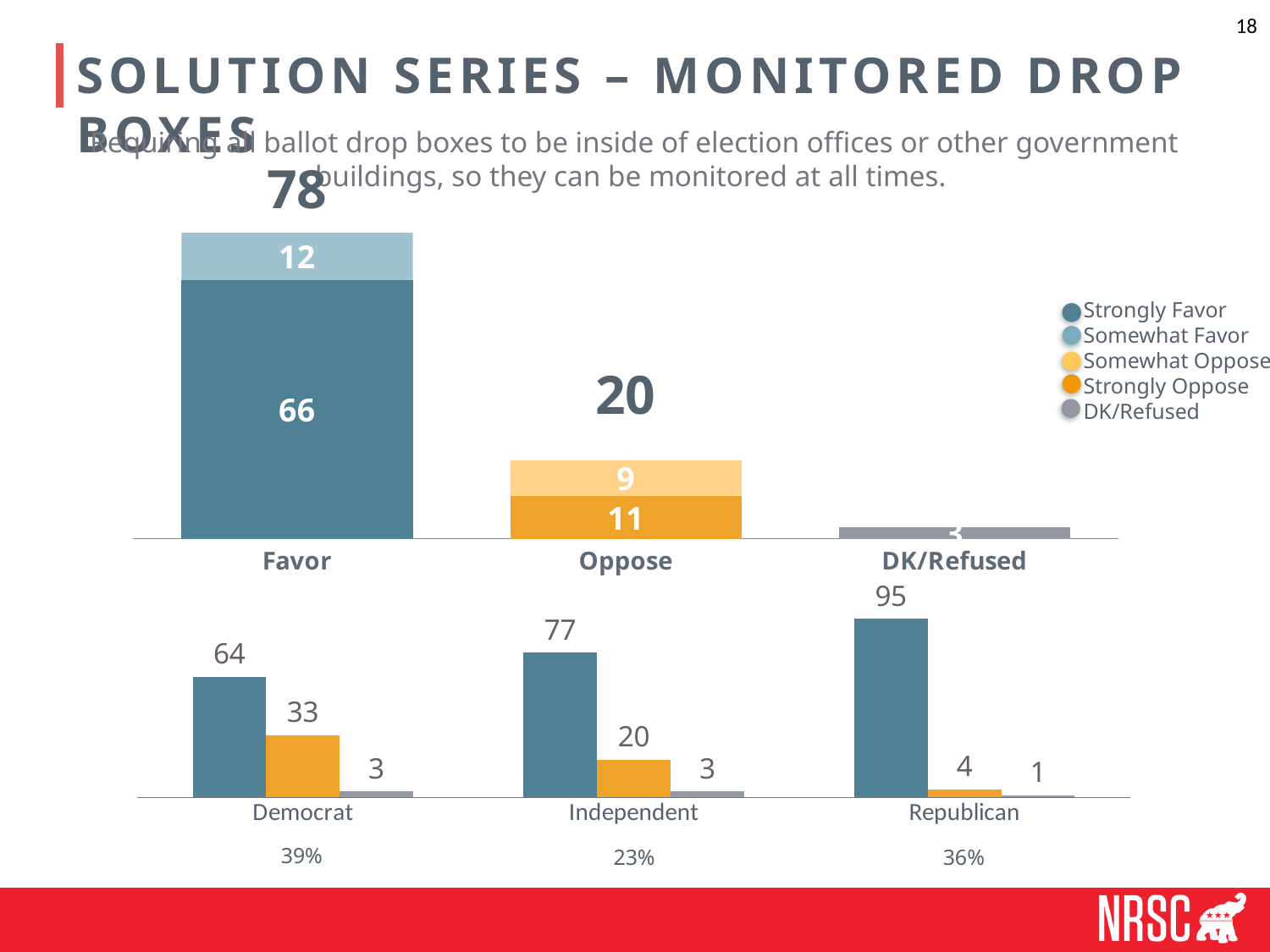
In the top stacked bar chart, what is the total shown above the Favor bar? 78 How many series does the legend of the top stacked bar chart list? 5 In the bottom chart by party, what is the value of the tallest bar for Republican? 95 In the top stacked bar chart, what is the Somewhat Favor value for the Favor bar? 12 In the bottom chart by party, what is the difference between the dark blue bar for Republican and the dark blue bar for Democrat? 31 In the bottom chart by party, which is larger: the orange bar for Democrat or the orange bar for Independent? Democrat In the top stacked bar chart, what is the Strongly Favor value for the Favor bar? 66 In the bottom chart by party, which party has the highest value for the dark blue (Strongly Favor) bar? Republican In the top stacked bar chart, what is the Strongly Oppose value for the Oppose bar? 11 What kind of chart is the bottom chart by party? Bar chart In the bottom chart by party, what is the value of the orange bar for Democrat? 33 In the top stacked bar chart, what is the total shown above the Oppose bar? 20